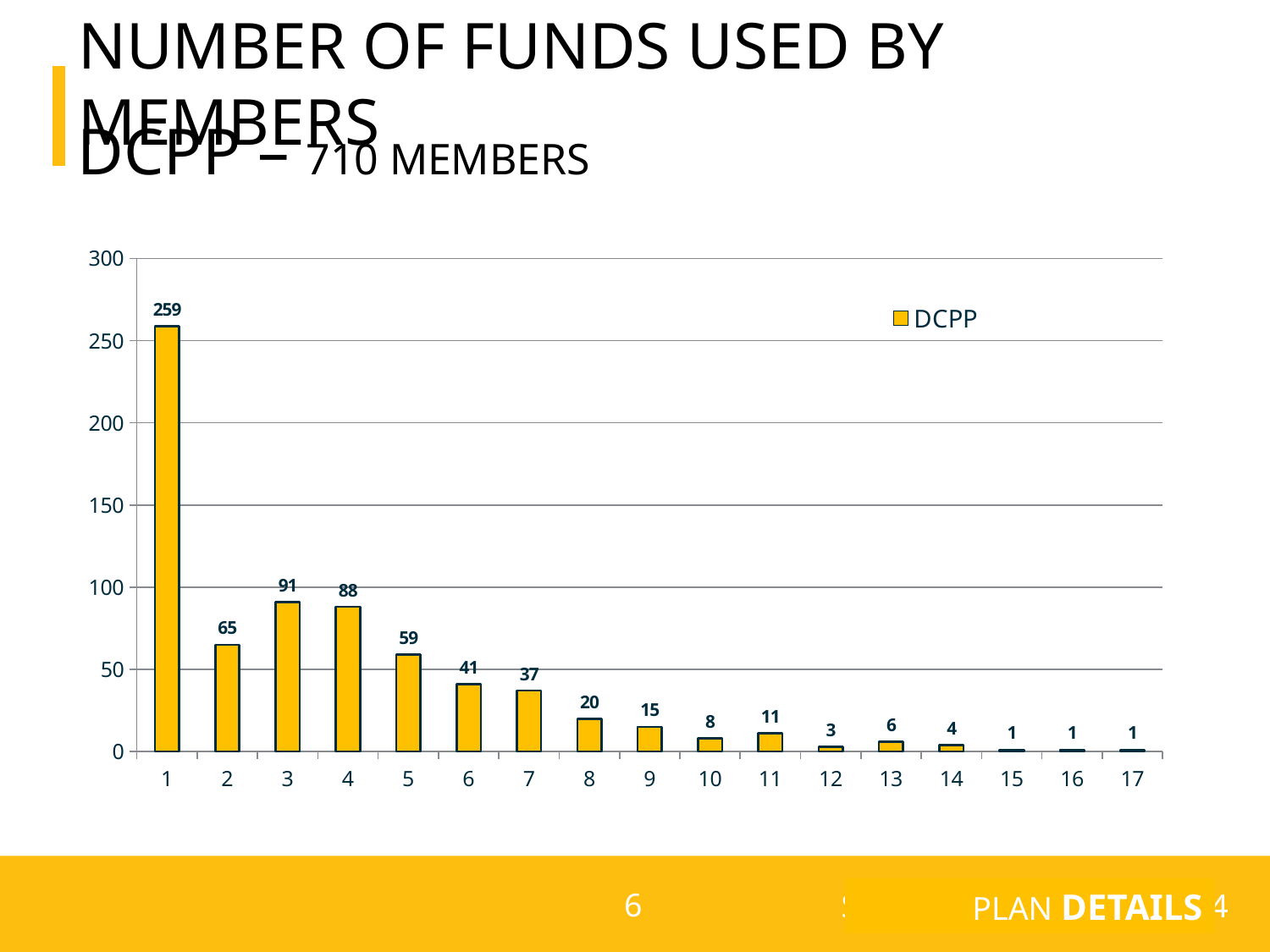
Is the value for category 1 greater or less than 250? greater How many members use 1 fund according to the chart? 259 Which is larger, the value for category 12 or the value for category 13? 13 What is the value for category 5 on the chart? 59 What kind of chart is shown on the slide? bar chart How many series does the legend list? 1 What is the difference between the values for category 1 and category 2? 194 Which is larger, the value for category 6 or the value for category 7? 6 What is the difference between the values for category 3 and category 4? 3 Which category has the highest value on the chart? 1 How many categories are shown on the x axis of the chart? 17 What is the value for category 11 on the chart? 11